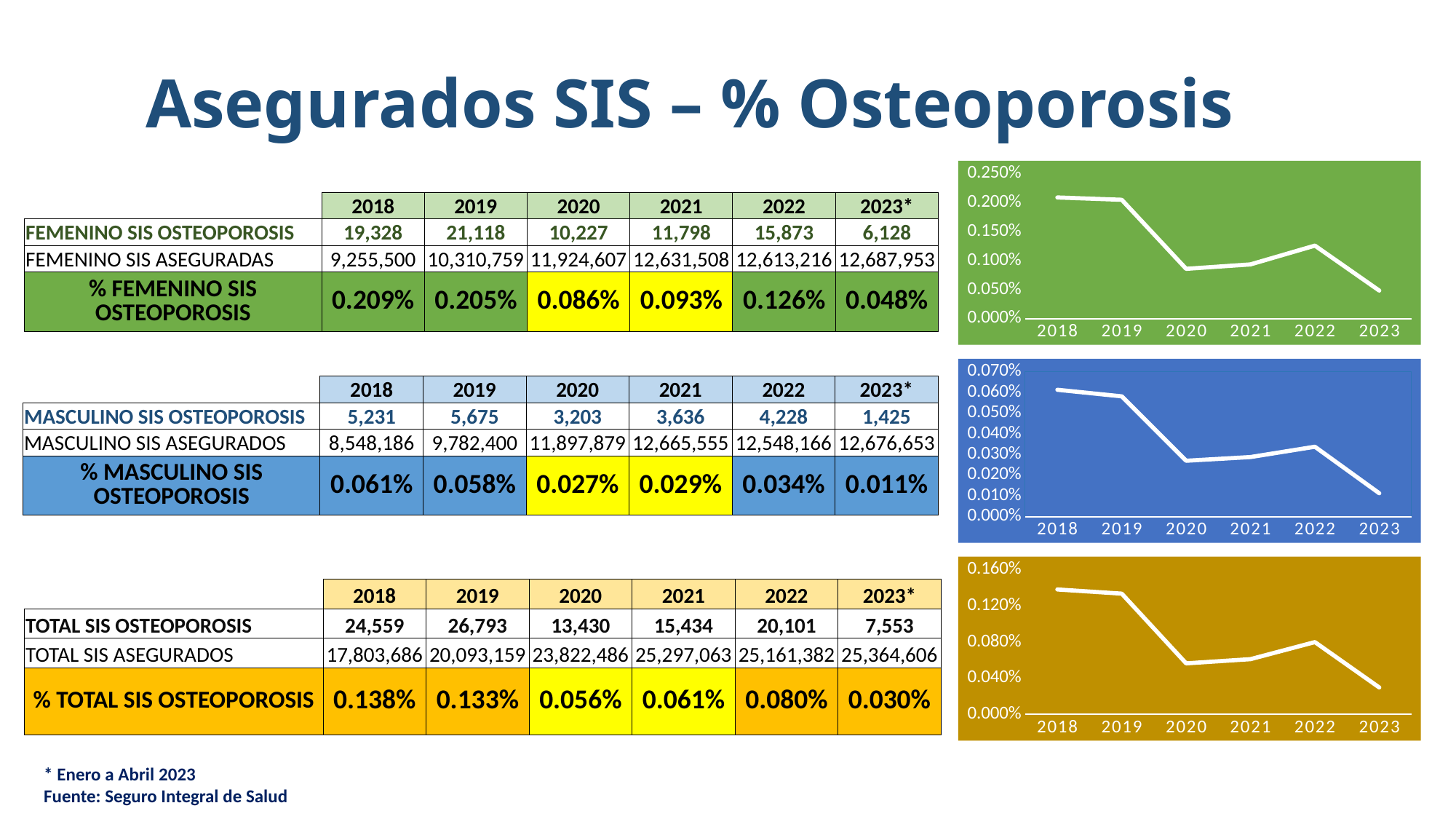
What kind of chart is the green chart at the top right of the slide? line chart In the blue line chart (middle right), is the value for 2018 greater or less than 0.050%? greater In the green line chart (top right), do the values generally rise or fall from 2018 to 2023? fall In the green line chart (top right), which year has the lowest value? 2023 In the green line chart (top right), which year has the larger value, 2021 or 2022? 2022 How many years are plotted along the x axis of the green line chart (top right)? 6 In the green line chart (top right), what is the difference between the 2018 value and the 2023 value (% FEMENINO SIS OSTEOPOROSIS)? 0.161% How many line charts are shown on the slide? 3 In the green line chart (top right), what is the value for 2018 (% FEMENINO SIS OSTEOPOROSIS)? 0.209% In the blue line chart (middle right), what is the value for 2020 (% MASCULINO SIS OSTEOPOROSIS)? 0.027% In the green line chart (top right), is the value for 2020 greater or less than 0.100%? less In the orange line chart (bottom right), is the value for 2020 greater or less than 0.040%? greater